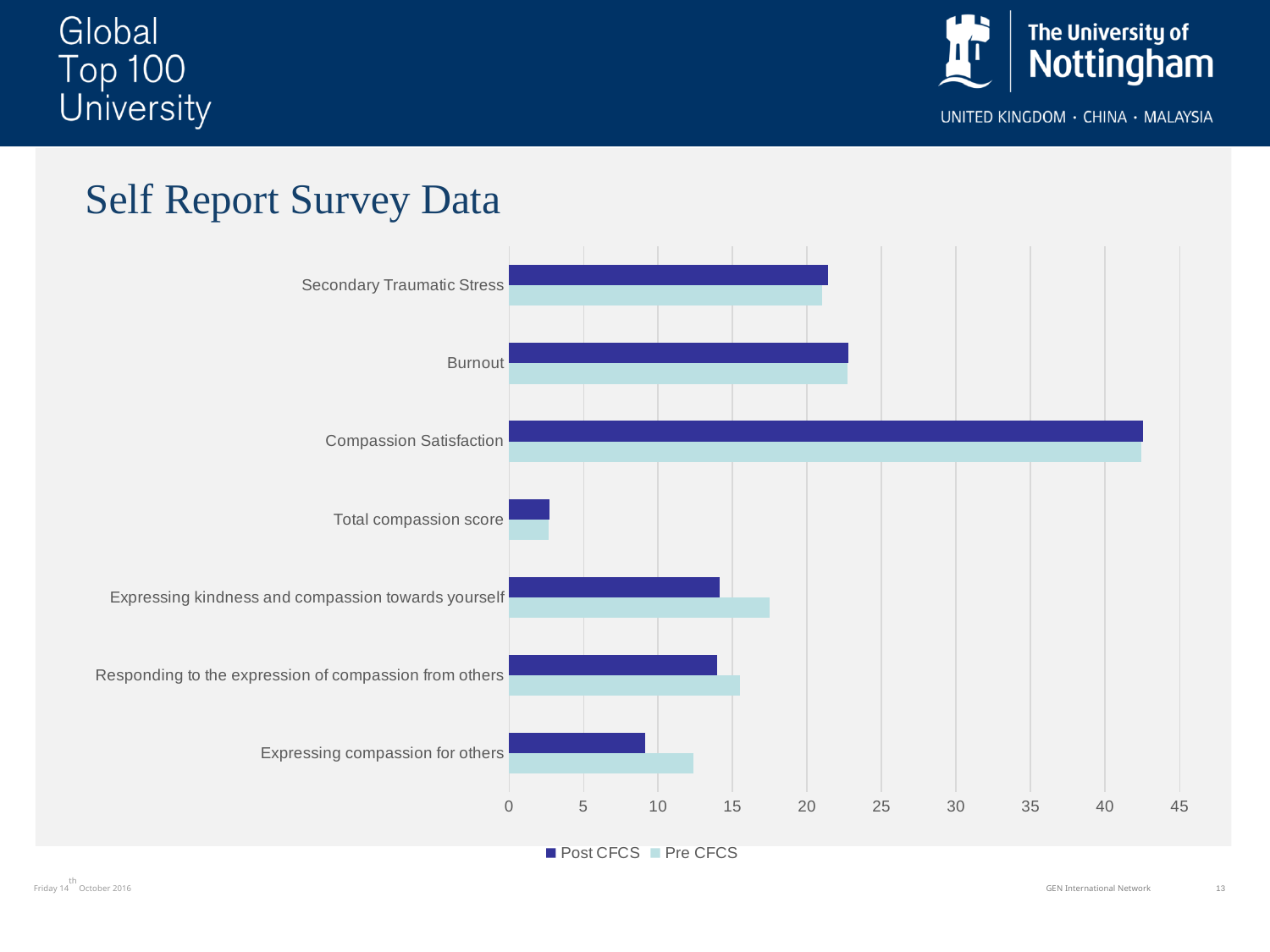
Which category has the highest Post CFCS value? Compassion Satisfaction What is the title of the chart on the slide? Self Report Survey Data How many categories are shown on the chart? 7 Which category has the lowest Pre CFCS value? Total compassion score For Expressing kindness and compassion towards yourself, which is larger: the Post CFCS value or the Pre CFCS value? Pre CFCS Is the Post CFCS value for Burnout greater or less than 20? greater For Expressing compassion for others, which is larger: the Post CFCS value or the Pre CFCS value? Pre CFCS Is the Pre CFCS value for Total compassion score greater or less than 5? less Is the Pre CFCS value for Expressing compassion for others greater or less than 15? less What kind of chart is shown on the slide? bar chart How many series does the legend list? 2